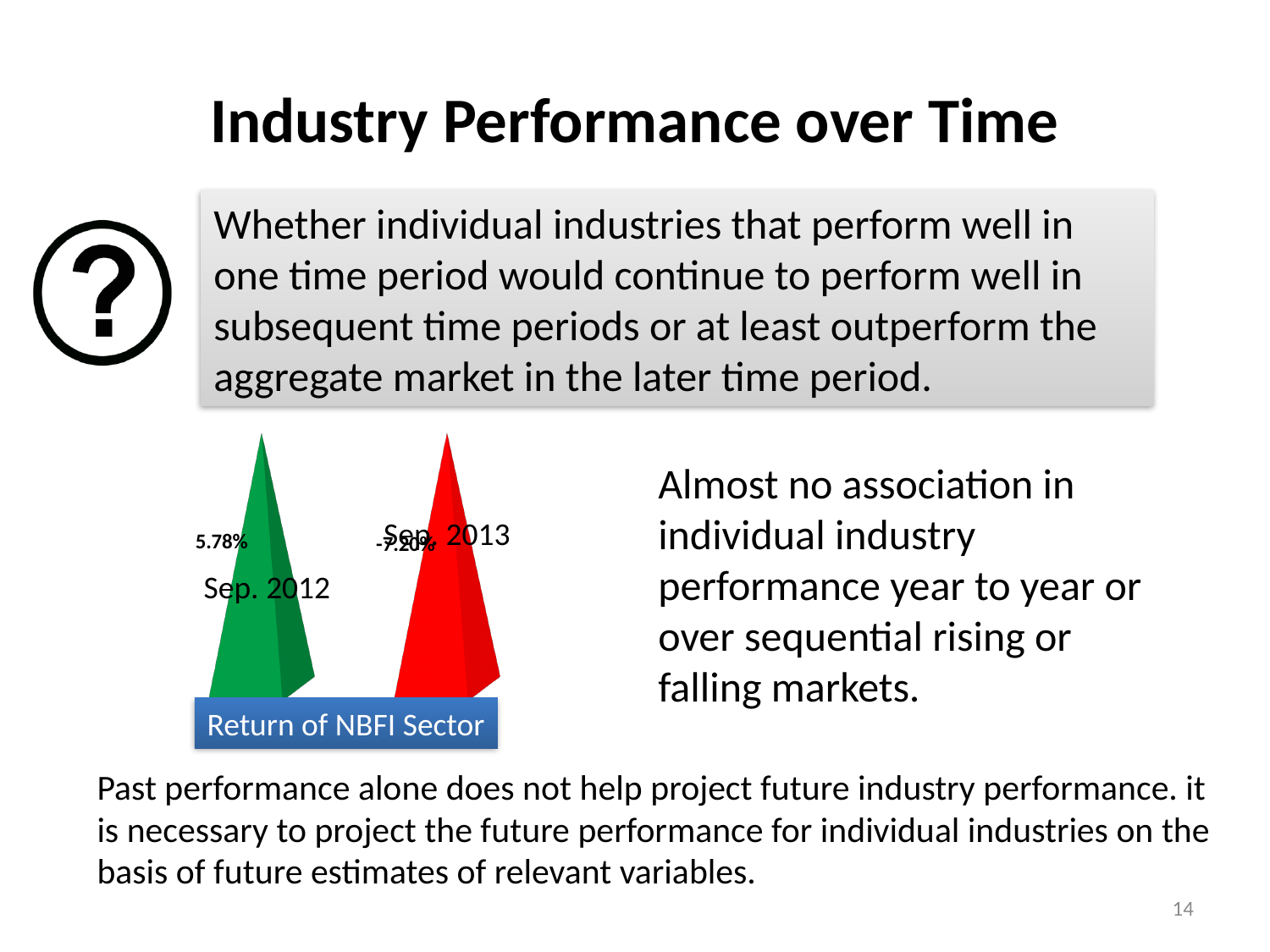
What is the difference between the Sep. 2012 and Sep. 2013 returns? 12.98% Which period shows the higher return of the NBFI sector? Sep. 2012 What is the return of the NBFI sector for Sep. 2013? -7.20% What is the title of the chart? Return of NBFI Sector Which period shows the lowest return of the NBFI sector? Sep. 2013 What colour is the bar for Sep. 2012? Green What is the return of the NBFI sector for Sep. 2012? 5.78% How many periods are plotted in the chart? 2 What kind of chart is shown on the slide? Bar chart Is the return for Sep. 2012 or Sep. 2013 larger? Sep. 2012 Does the return of the NBFI sector rise or fall from Sep. 2012 to Sep. 2013? Fall